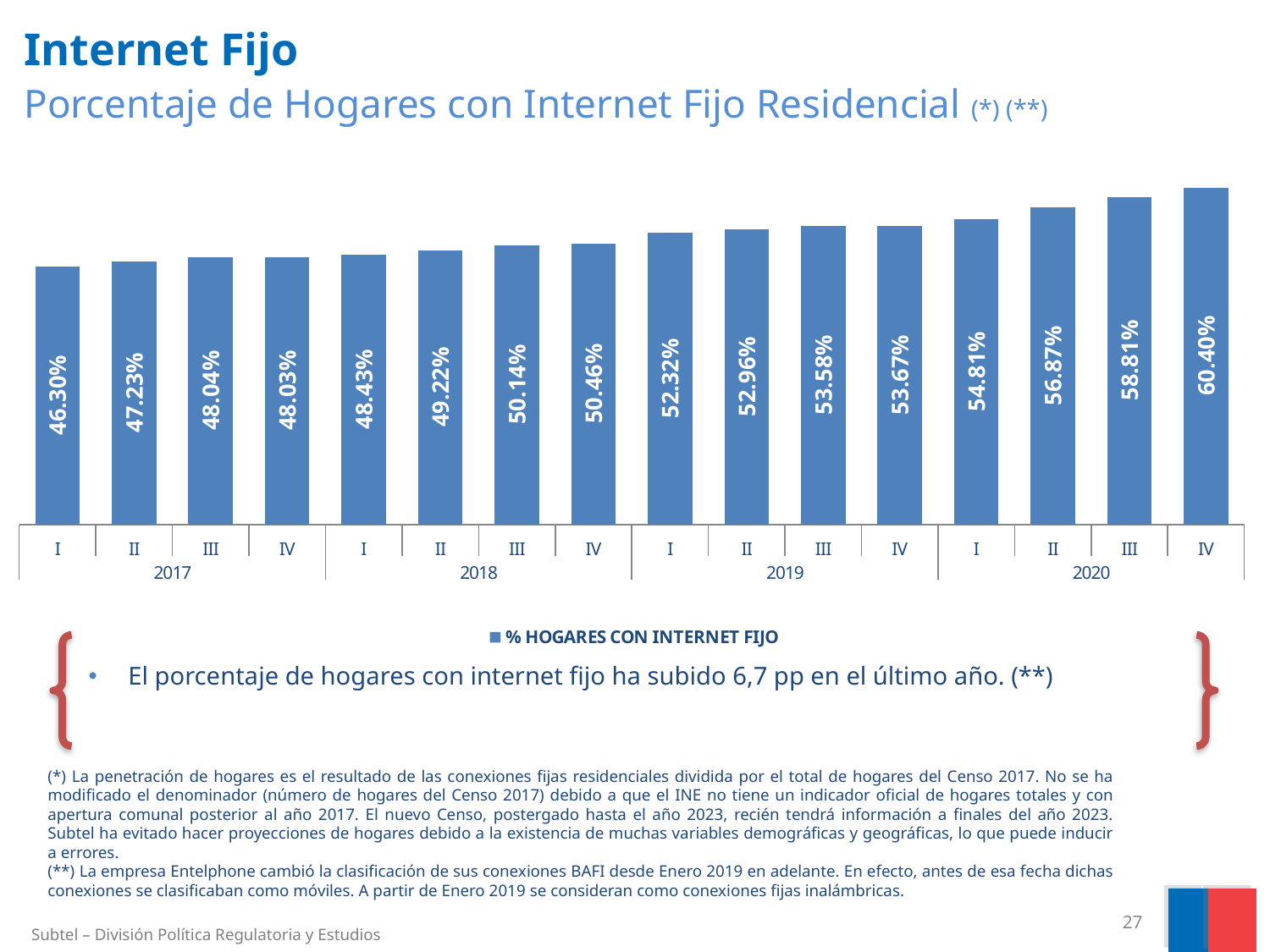
What is the value for quarter I of 2017? 46.30% How many bars are plotted in the chart? 16 Which quarter has the highest value? IV 2020 What is the value for quarter II of 2019? 52.96% Do the values generally rise or fall from quarter I of 2017 to quarter IV of 2020? Rise Which quarter has the lowest value? I 2017 What kind of chart is shown on the slide? Bar chart How many series does the legend list? 1 Which is larger, the value for quarter III of 2018 or the value for quarter I of 2019? I 2019 What is the difference between the values for quarter IV of 2020 and quarter IV of 2019? 6.73% What is the legend entry for the series shown in the chart? % HOGARES CON INTERNET FIJO What is the value for quarter IV of 2020? 60.40%